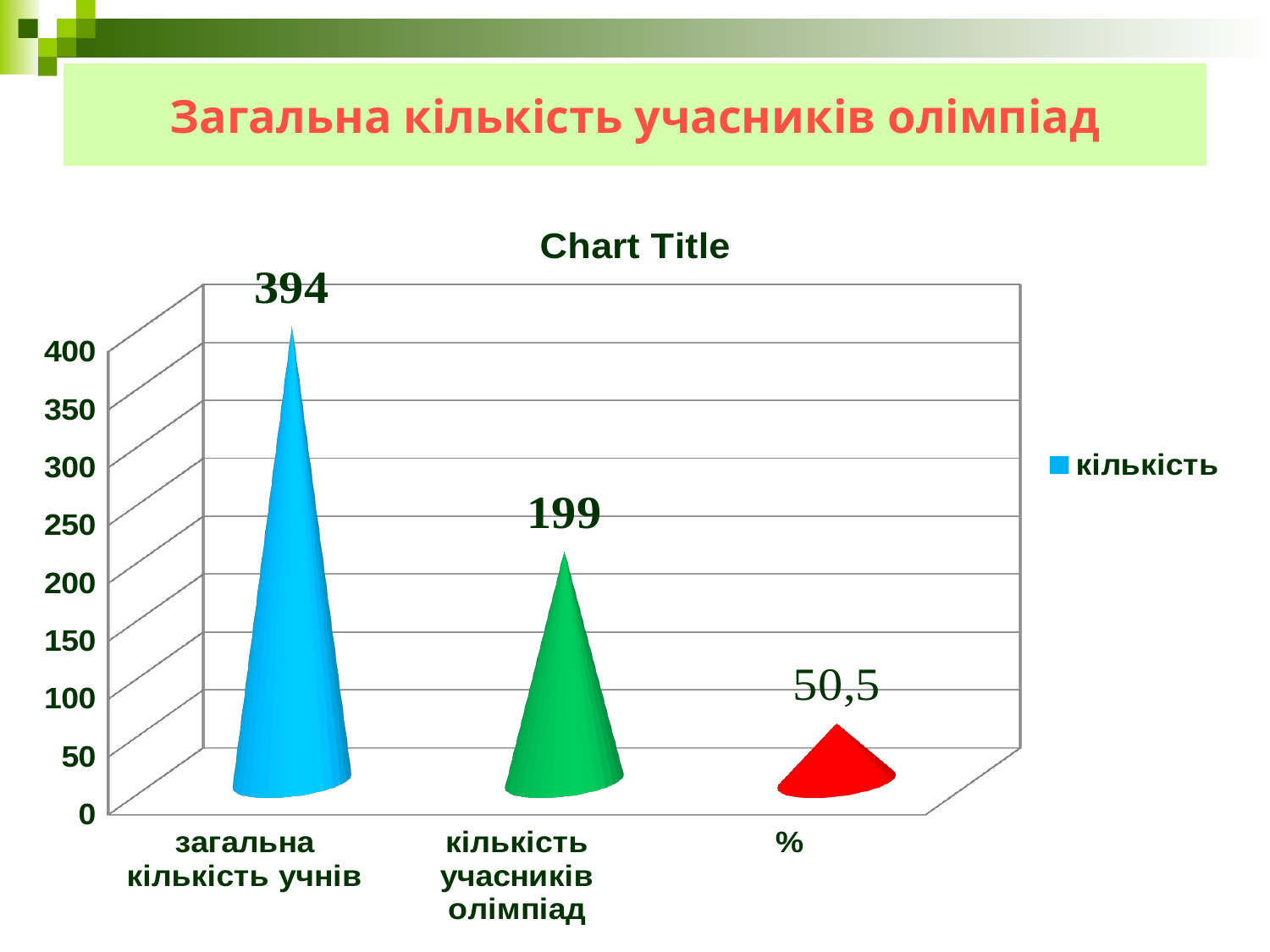
Is the value for кількість учасників олімпіад greater or less than 150? greater Which category has the highest value? загальна кількість учнів How many categories are shown on the x axis? 3 What is the name of the series listed in the legend? кількість What is the value for загальна кількість учнів? 394 What is the difference between the values for загальна кількість учнів and кількість учасників олімпіад? 195 What is the value for кількість учасників олімпіад? 199 Which category has the lowest value? % What is the value for the % category? 50,5 Which is larger, the value for кількість учасників олімпіад or the value for %? кількість учасників олімпіад What kind of chart is shown on the slide? bar chart How many series does the legend list? 1